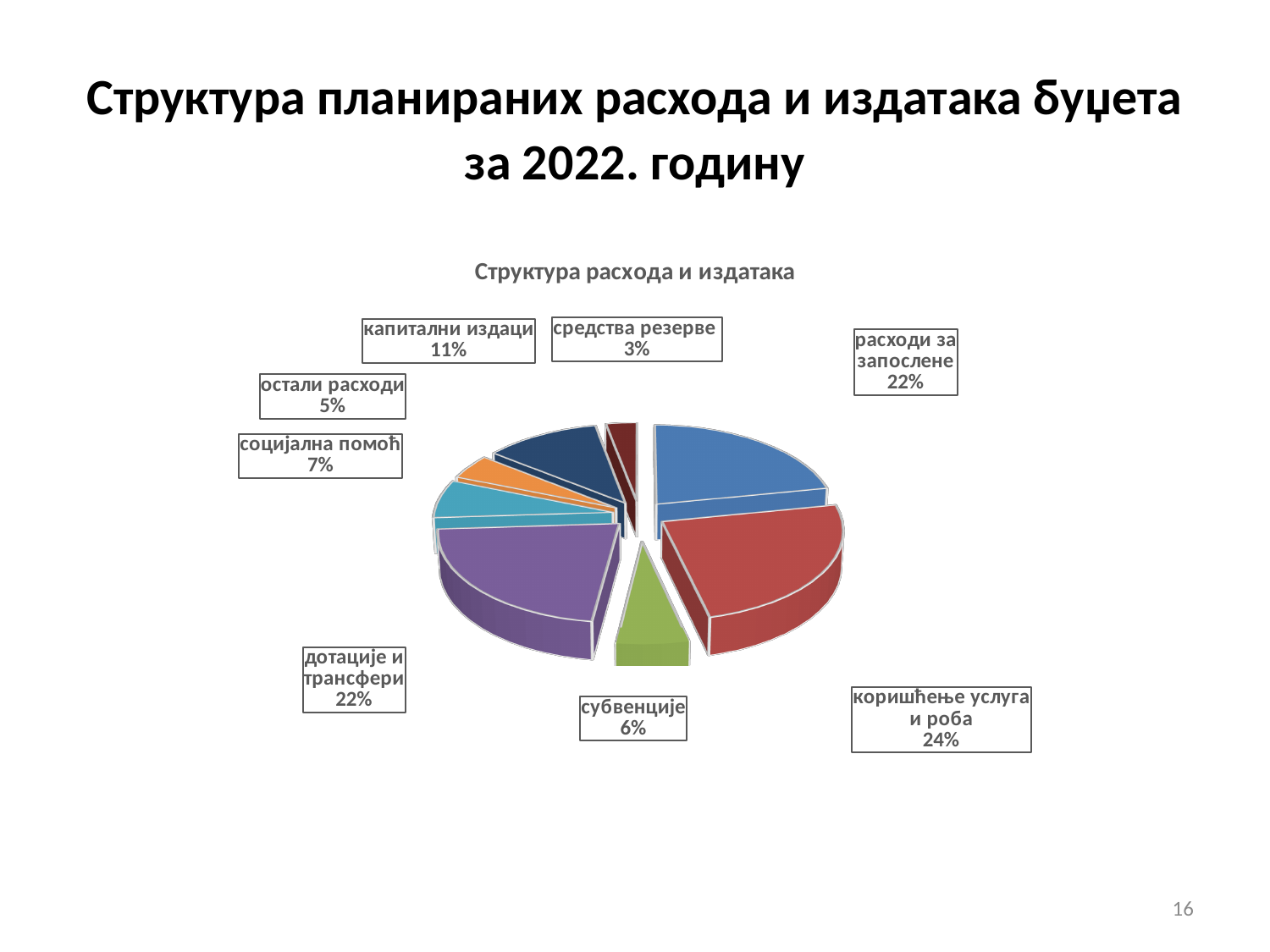
What is the combined share of расходи за запослене and средства резерве? 25% Which category has the largest share of the pie? коришћење услуга и роба What is the title of the chart? Структура расхода и издатака What percentage is shown for социјална помоћ? 7% What percentage is shown for капитални издаци? 11% What is the difference in percentage points between коришћење услуга и роба and капитални издаци? 13 What kind of chart is shown on the slide? pie chart How many categories (slices) does the pie chart have? 8 Which category has the smallest share of the pie? средства резерве Which is larger, the share for субвенције or the share for остали расходи? субвенције What share of the pie is labelled for коришћење услуга и роба? 24% What percentage is shown for дотације и трансфери? 22%